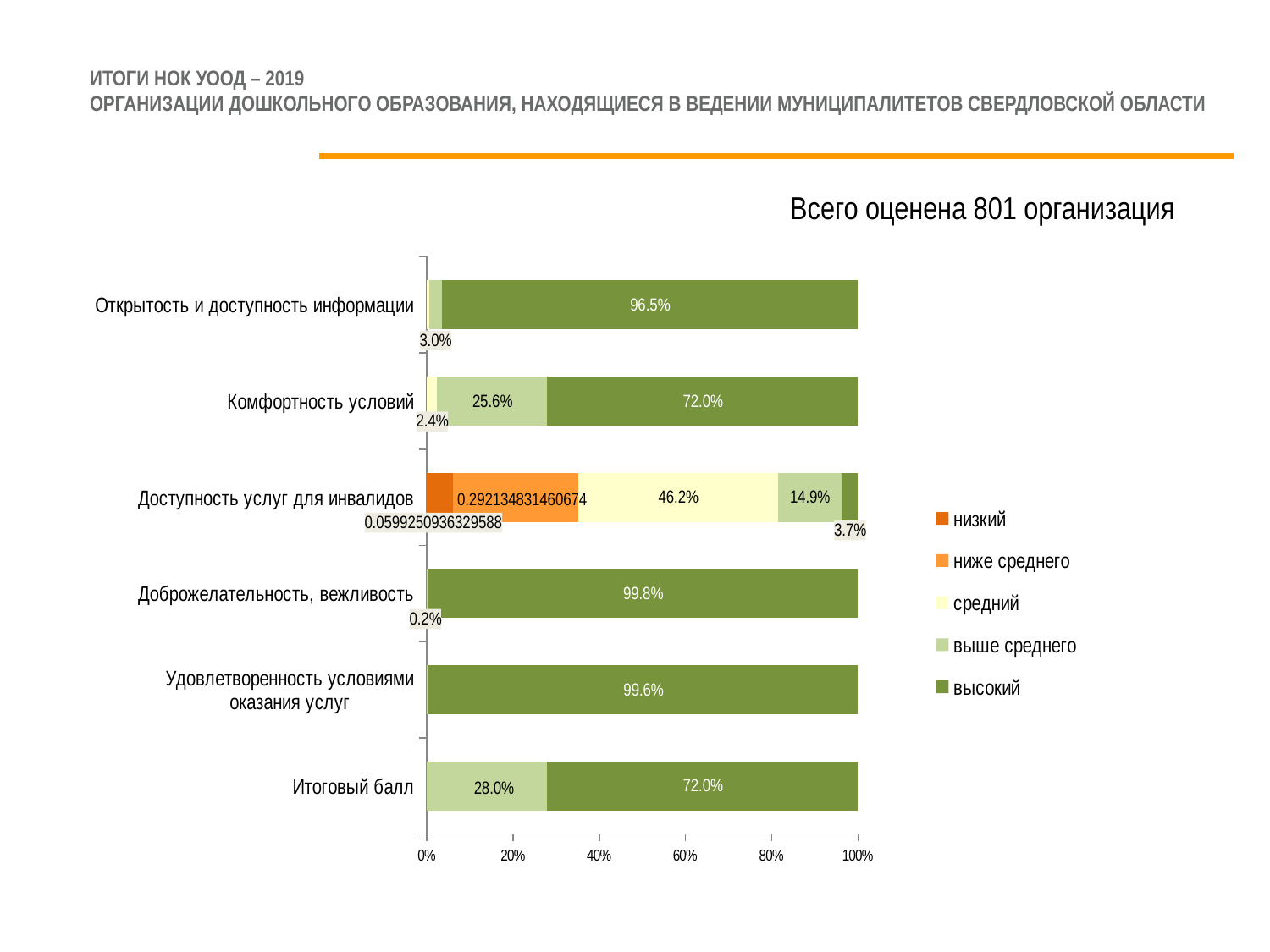
What kind of chart is shown on the slide? stacked bar chart According to the text above the chart, how many organisations were evaluated in total? 801 What is the value of the 'высокий' segment for 'Доброжелательность, вежливость'? 99.8% What is the value of the 'высокий' segment for 'Открытость и доступность информации'? 96.5% What is the value of the 'выше среднего' segment for 'Итоговый балл'? 28.0% Which category has the lowest 'высокий' value? Доступность услуг для инвалидов What is the value of the 'средний' segment for 'Доступность услуг для инвалидов'? 46.2% How many series does the legend list? 5 What is the value of the 'выше среднего' segment for 'Комфортность условий'? 25.6% Which category has the highest 'высокий' value? Доброжелательность, вежливость What is the difference between the 'высокий' values for 'Доброжелательность, вежливость' and 'Удовлетворенность условиями оказания услуг'? 0.2% How many categories are plotted on the chart? 6